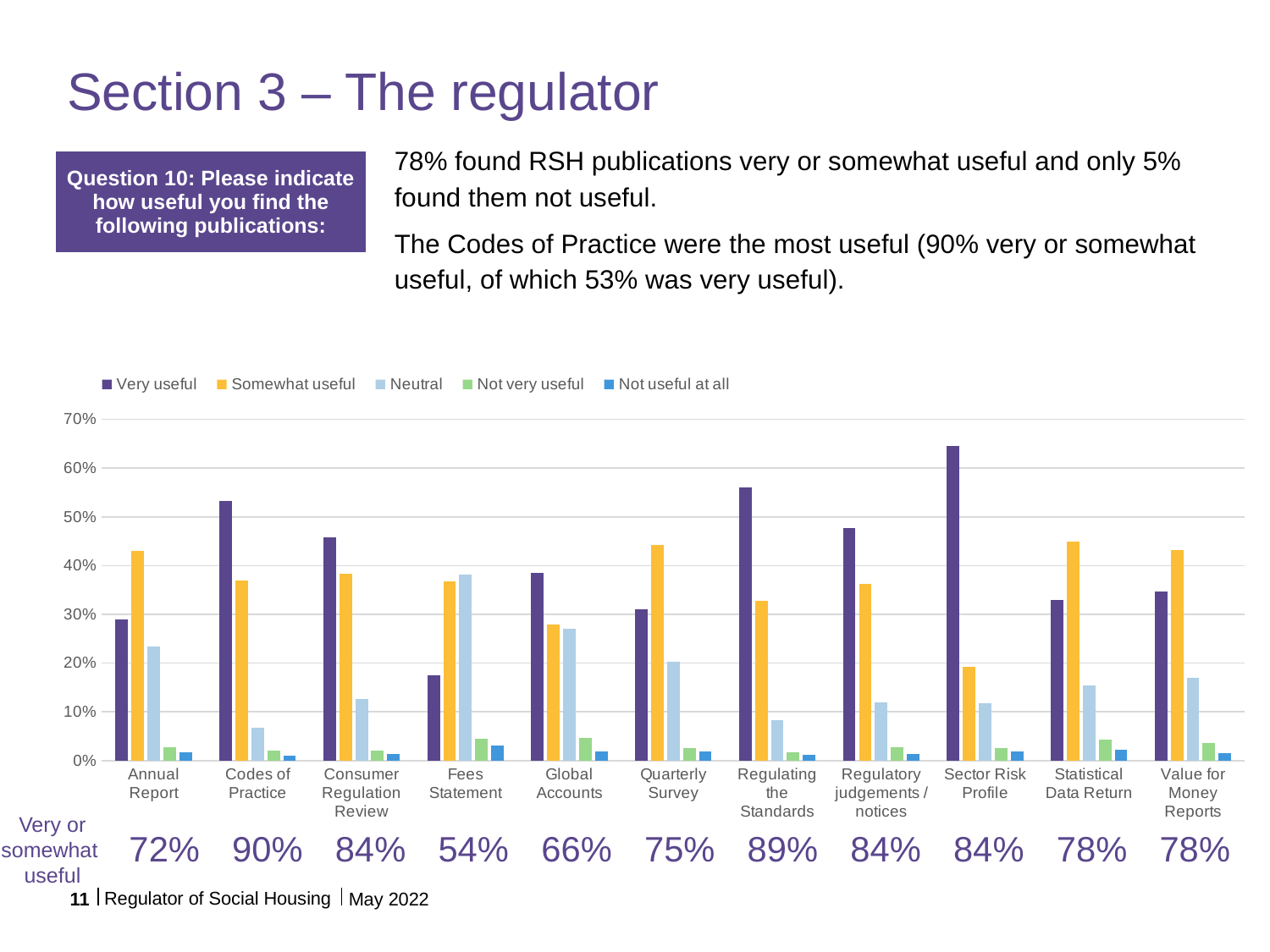
For Annual Report, which is larger: the 'Very useful' bar or the 'Somewhat useful' bar? Somewhat useful What is the 'Very or somewhat useful' percentage shown for Codes of Practice? 90% How many series does the chart legend list? 5 What is the 'Very or somewhat useful' percentage shown for Fees Statement? 54% Is the 'Neutral' value for Fees Statement greater or less than 30%? greater Is the 'Very useful' value for Sector Risk Profile greater or less than 60%? greater How many publications (categories) are shown along the x axis of the chart? 11 Which publication has the highest 'Very useful' bar? Sector Risk Profile What kind of chart is shown on the slide? Bar chart Which publication has the lowest 'Very or somewhat useful' percentage shown beneath the chart? Fees Statement Which publication has the lowest 'Very useful' bar? Fees Statement What is the difference between the 'Very or somewhat useful' percentages for Codes of Practice and Fees Statement? 36 percentage points